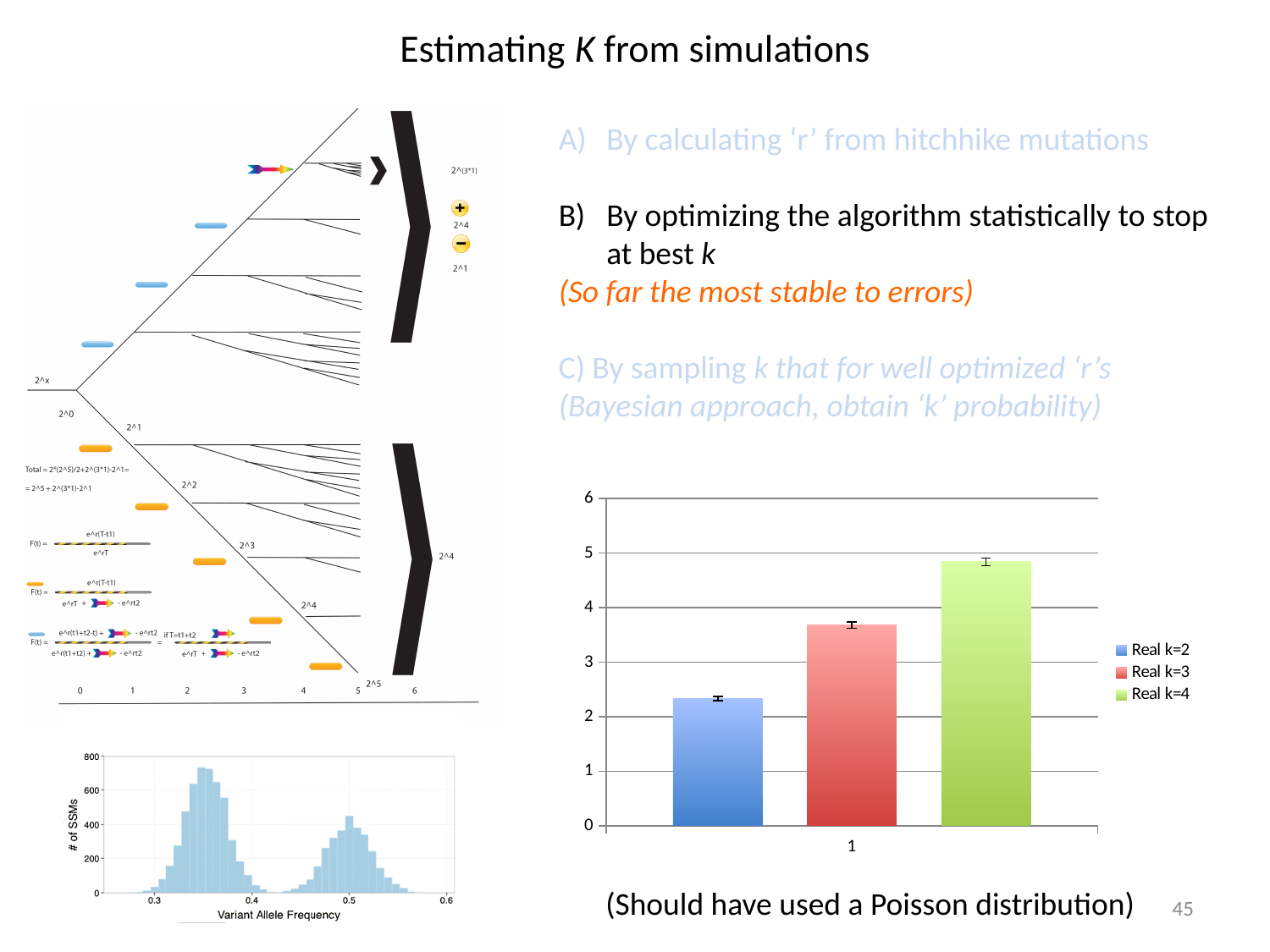
What kind of chart is the chart on the right of the slide with the legend Real k=2, Real k=3, Real k=4? bar chart In the histogram at the bottom left, is the tallest peak (near 0.35) greater or less than 600 on the # of SSMs axis? greater What is the x-axis label of the histogram at the bottom left of the slide? Variant Allele Frequency In the bar chart on the right, how many series does the legend list? 3 In the bar chart on the right, what colour is the bar for Real k=4? green In the bar chart on the right, what is the highest value shown on the vertical axis? 6 In the bar chart on the right, is the bar for Real k=4 greater or less than 4? greater In the bar chart on the right, is the bar for Real k=3 greater or less than 3? greater In the bar chart on the right, which is larger, the bar for Real k=2 or the bar for Real k=3? Real k=3 In the bar chart on the right, which series has the highest bar? Real k=4 In the bar chart on the right, which series has the lowest bar? Real k=2